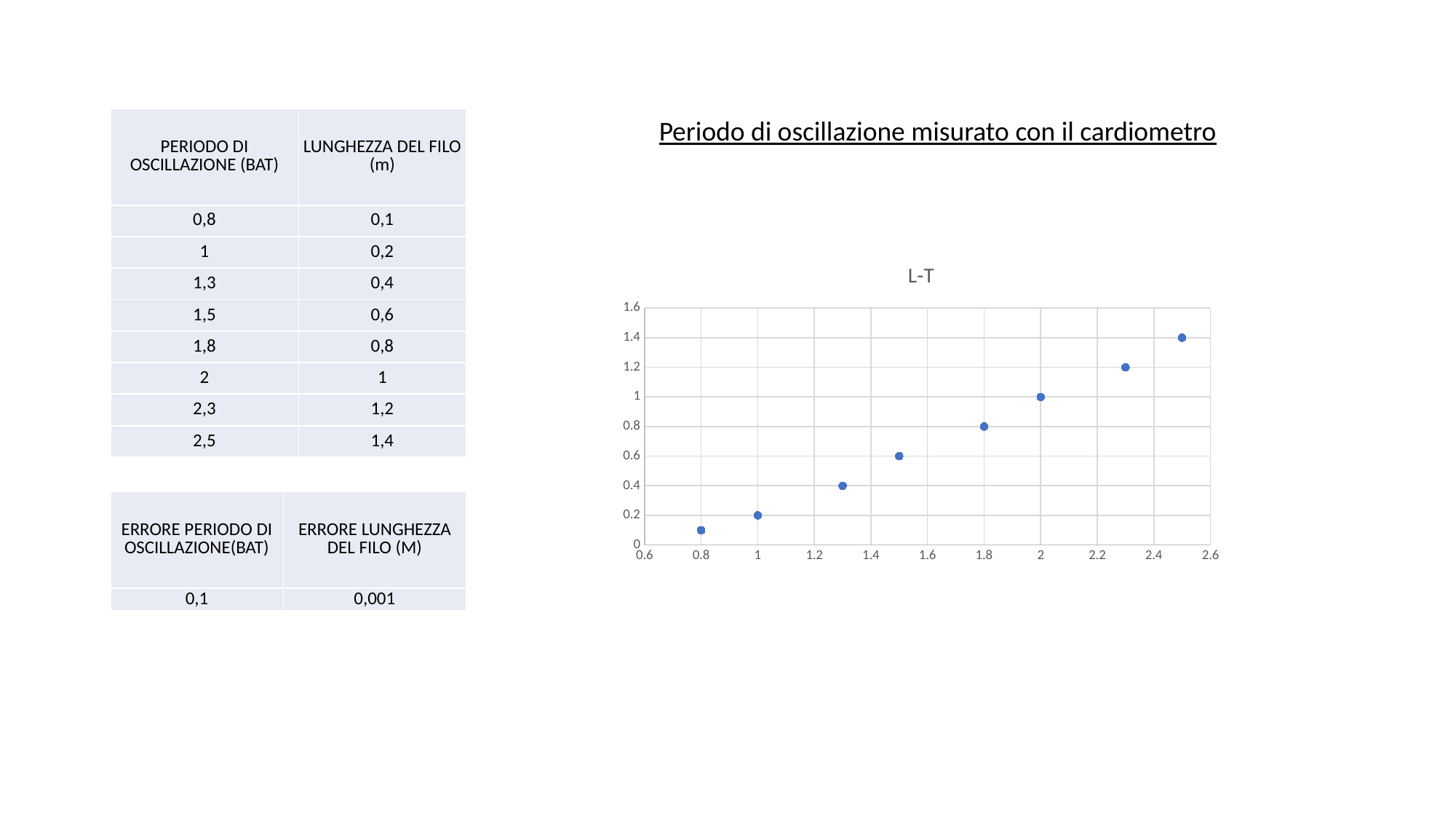
In the L-T chart, is the y value at x = 2.5 greater or less than 1.2? greater What kind of chart is the L-T chart? scatter chart In the L-T chart, which point has the lowest y value? the point at x = 0.8 In the L-T chart, do the y values rise or fall as x increases? rise How many data points are plotted in the L-T chart? 8 In the L-T chart, what is the difference between the y values at x = 2 and x = 1.8? 0.2 In the L-T chart, what is the y value of the point at x = 2? 1 In the L-T chart, which point has the highest y value? the point at x = 2.5 What is the title of the chart on the slide? L-T In the L-T chart, which has the larger y value: the point at x = 2.3 or the point at x = 1.5? the point at x = 2.3 In the L-T chart, what is the y value of the point at x = 1.8? 0.8 In the L-T chart, what is the y value of the point at x = 1? 0.2